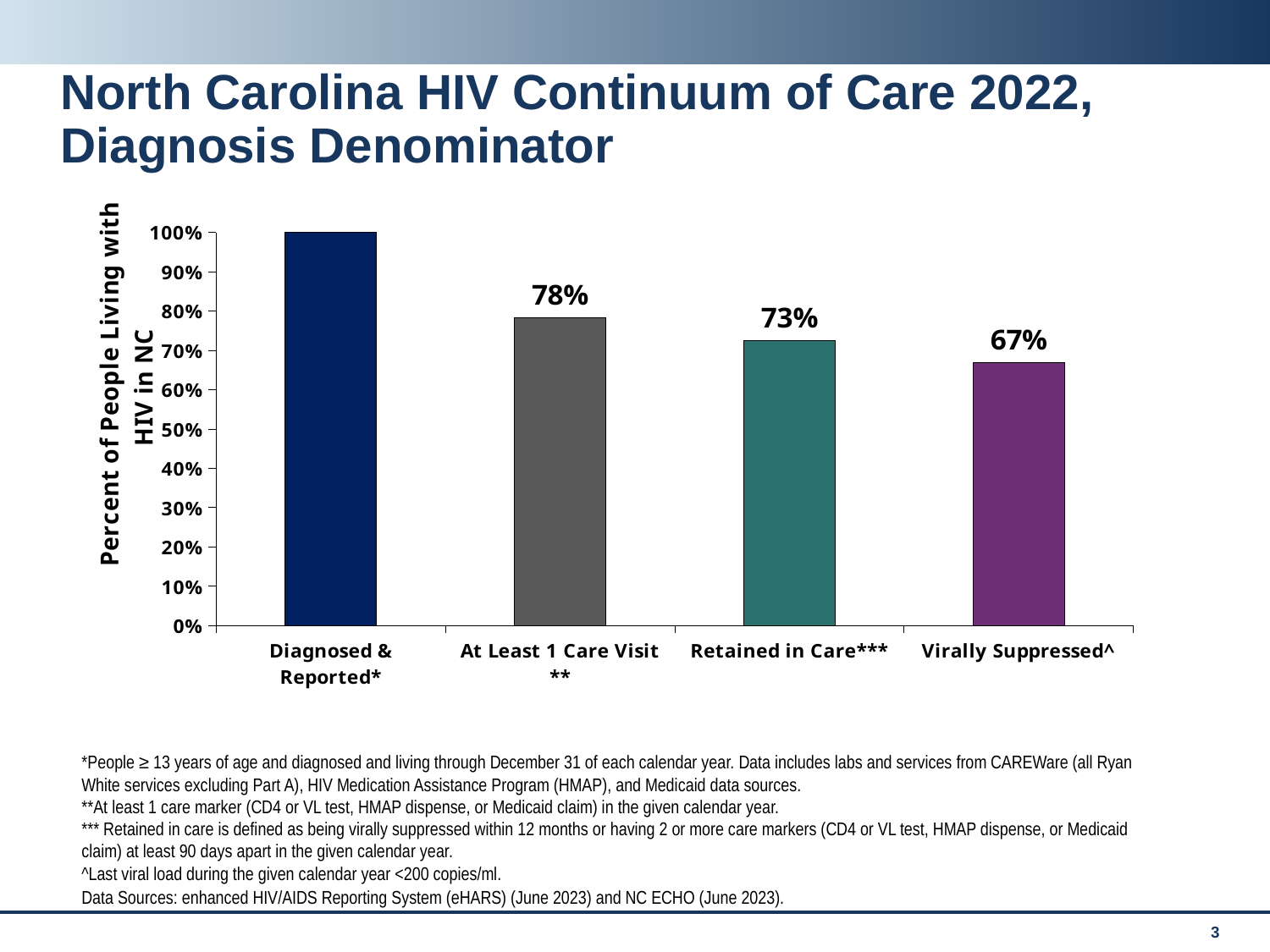
What is the value for Retained in Care***? 73% Which is larger, At Least 1 Care Visit** or Retained in Care***? At Least 1 Care Visit** What is the value for Virally Suppressed^? 67% What kind of chart is shown on the slide? Bar chart What is the value for Diagnosed & Reported*? 100% Do the values rise or fall from left to right along the x axis? Fall Which category has the lowest value? Virally Suppressed^ Which category has the highest value? Diagnosed & Reported* How many categories are shown on the x axis? 4 What is the difference between At Least 1 Care Visit** and Virally Suppressed^? 11 percentage points What is the difference between Retained in Care*** and Virally Suppressed^? 6 percentage points What is the value for At Least 1 Care Visit**? 78%